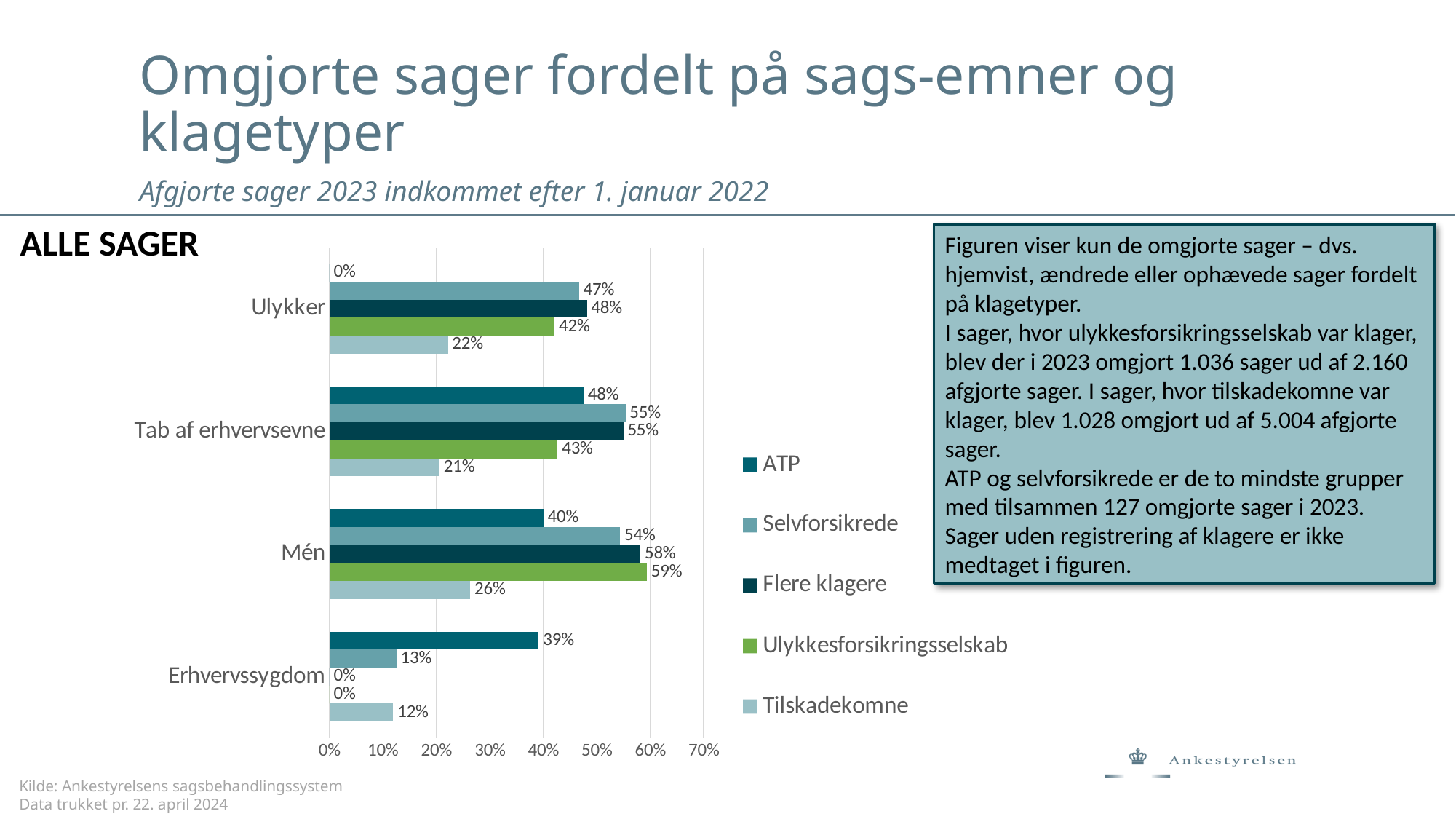
What is the value for Selvforsikrede in the Ulykker category? 47% How many categories are shown on the y axis of the chart? 4 What is the value for ATP in the Erhvervssygdom category? 39% How many series does the legend list? 5 Which is larger in the Erhvervssygdom category: the value for ATP or the value for Selvforsikrede? ATP What is the value for Tilskadekomne in the Mén category? 26% What is the difference between the Flere klagere value and the Tilskadekomne value in the Mén category? 32% What kind of chart is shown on the slide? Bar chart What is the value for Ulykkesforsikringsselskab in the Tab af erhvervsevne category? 43% Which category has the lowest value for ATP? Ulykker Which category has the highest value for Tilskadekomne? Mén What is the heading shown above the chart? ALLE SAGER